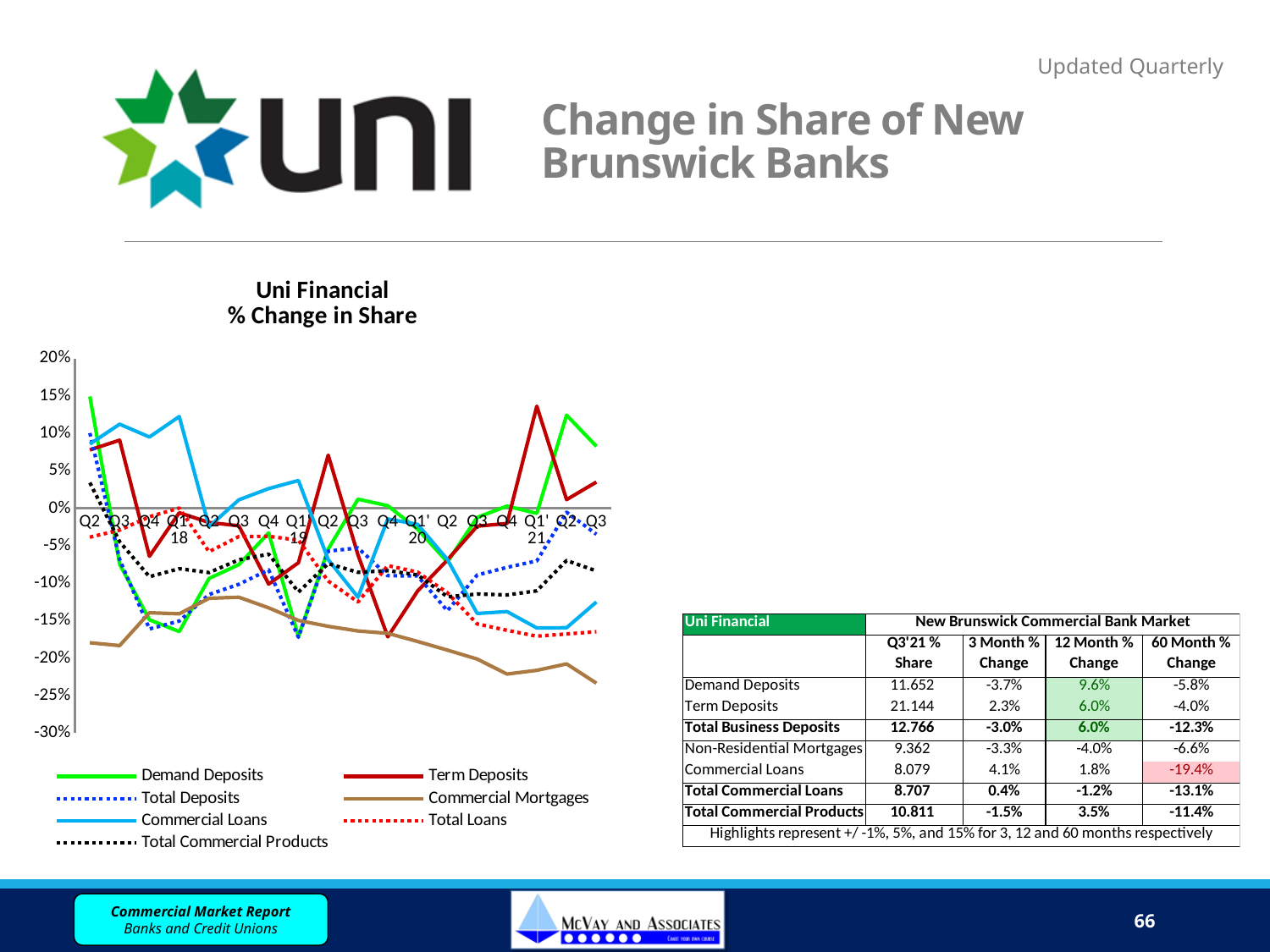
Which series has the lowest value at Q3 '21? Commercial Mortgages Which series in the chart is drawn with a brown solid line? Commercial Mortgages At Q3 '21, which is higher: Demand Deposits or Term Deposits? Demand Deposits What is the title of the chart on the slide? Uni Financial % Change in Share What is the highest value shown on the vertical axis of the chart? 20% How many series does the legend of the Uni Financial % Change in Share chart list? 7 Is the value for Term Deposits at Q1 '21 greater or less than 10%? greater What kind of chart is shown on the slide? line chart Is the value for Commercial Mortgages at Q3 '21 greater or less than -20%? less Does the Commercial Mortgages line end higher or lower at Q3 '21 than it starts at Q2 '18? lower Is the value for Commercial Loans at Q1 '18 greater or less than 10%? greater